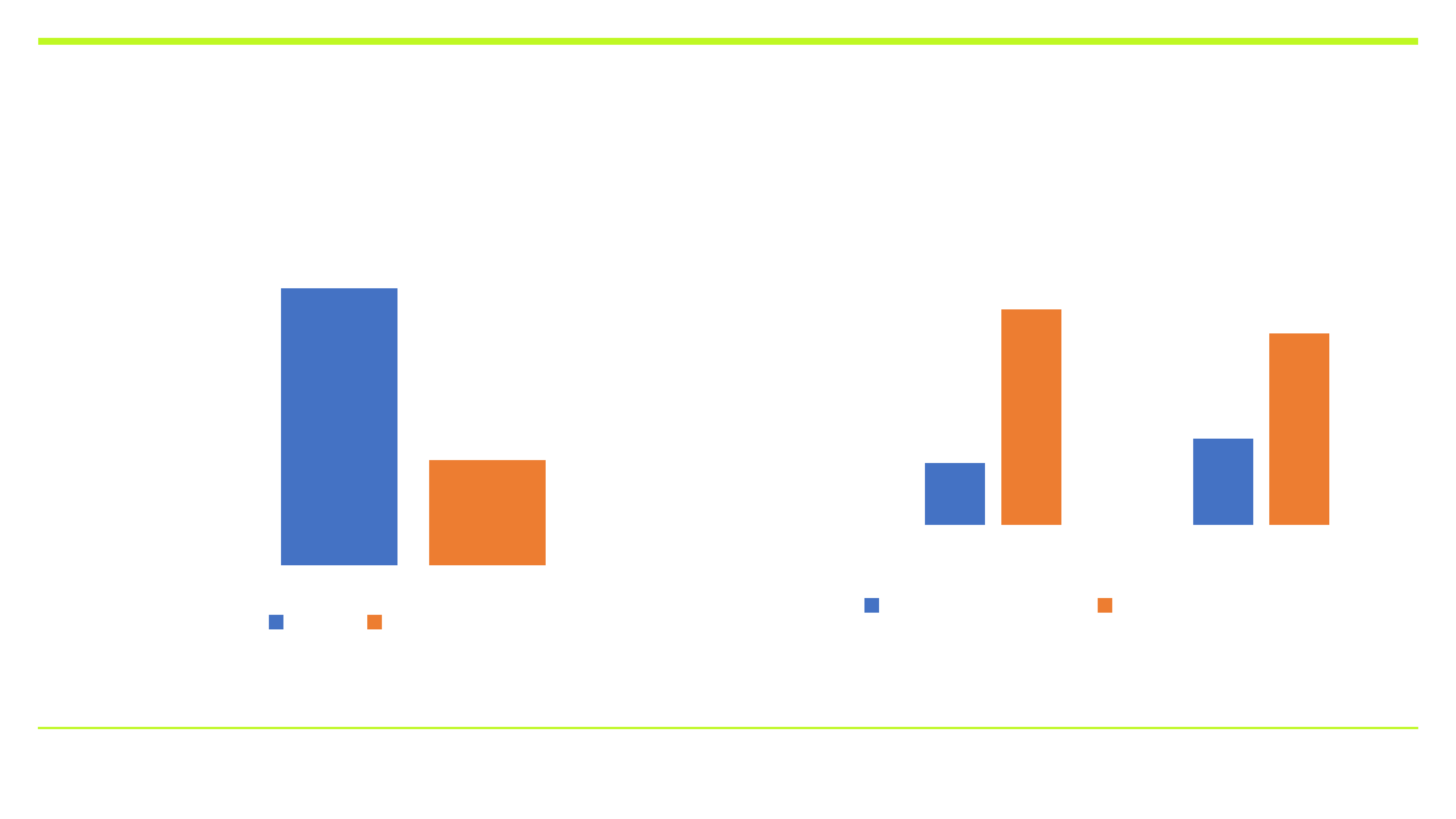
How many bars are plotted in the chart on the right side of the slide? 4 In the chart on the left side of the slide, which bar is taller, the blue bar or the orange bar? the blue bar In the chart on the left side of the slide, how many series does the legend list? 2 In the chart on the right side of the slide, which bar is the tallest? the orange bar in the left-hand group In the chart on the right side of the slide, how many series does the legend list? 2 What kind of chart is the chart on the left side of the slide? bar chart How many bars are plotted in the chart on the left side of the slide? 2 What two colours are used for the bars in the charts on the slide? blue and orange What kind of chart is the chart on the right side of the slide? bar chart In the chart on the right side of the slide, which bar is taller in the left-hand group, the blue bar or the orange bar? the orange bar How many groups of bars are there in the chart on the right side of the slide? 2 In the chart on the right side of the slide, which bar is taller in the right-hand group, the blue bar or the orange bar? the orange bar